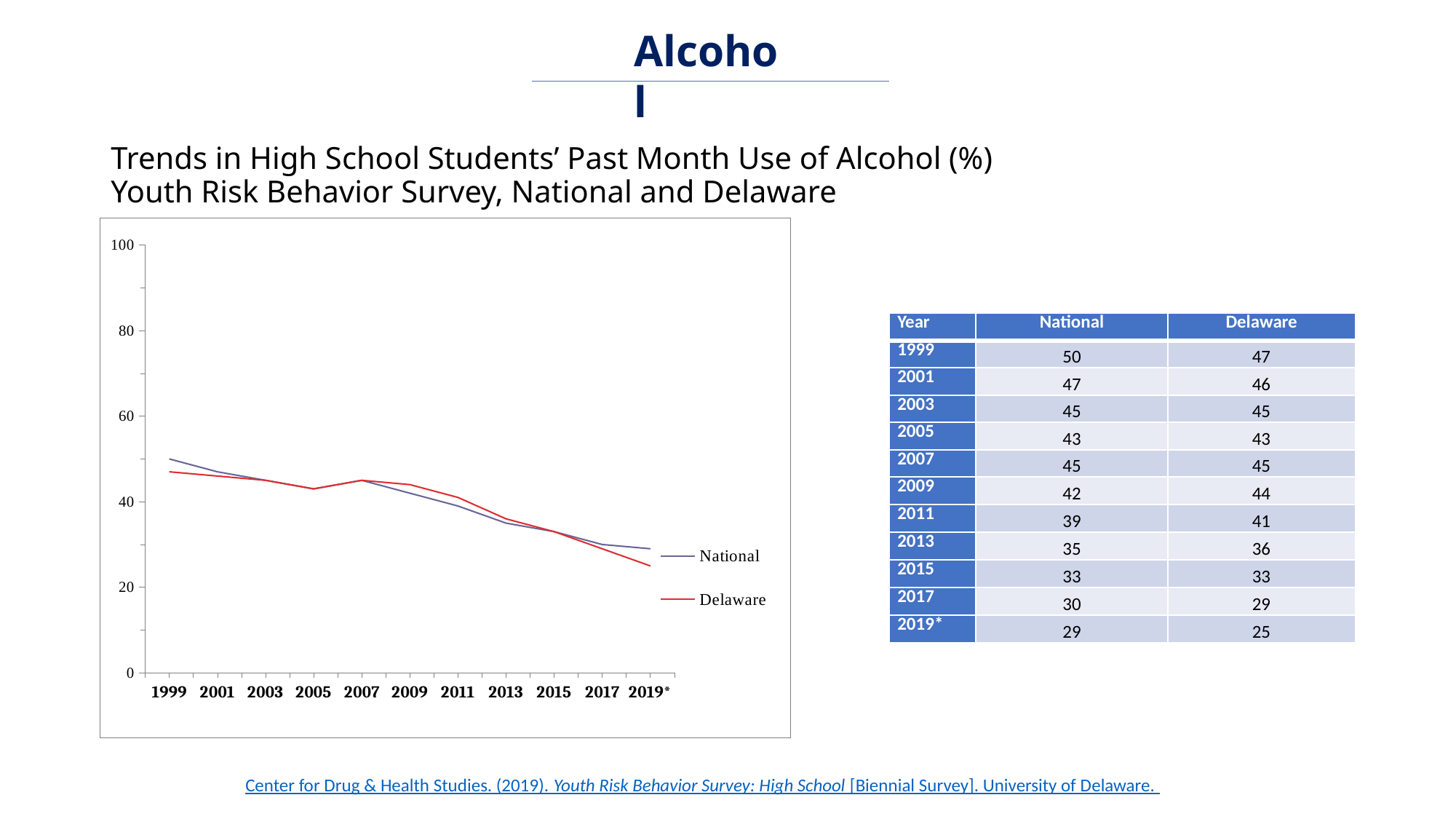
How many years are plotted along the x axis of the chart? 11 In which year is the National series at its highest? 1999 What is the Delaware value for 2019*? 25 What is the National value for 1999? 50 What is the difference between the National and Delaware values in 2019*? 4 In which year is the Delaware series at its lowest? 2019* How many series does the chart legend list? 2 Which is larger in 2009, the National value or the Delaware value? Delaware Which colour is used for the Delaware line in the chart? red What kind of chart is shown on the slide? line chart What is the Delaware value for 2009? 44 Overall, do the National values rise or fall from 1999 to 2019*? fall